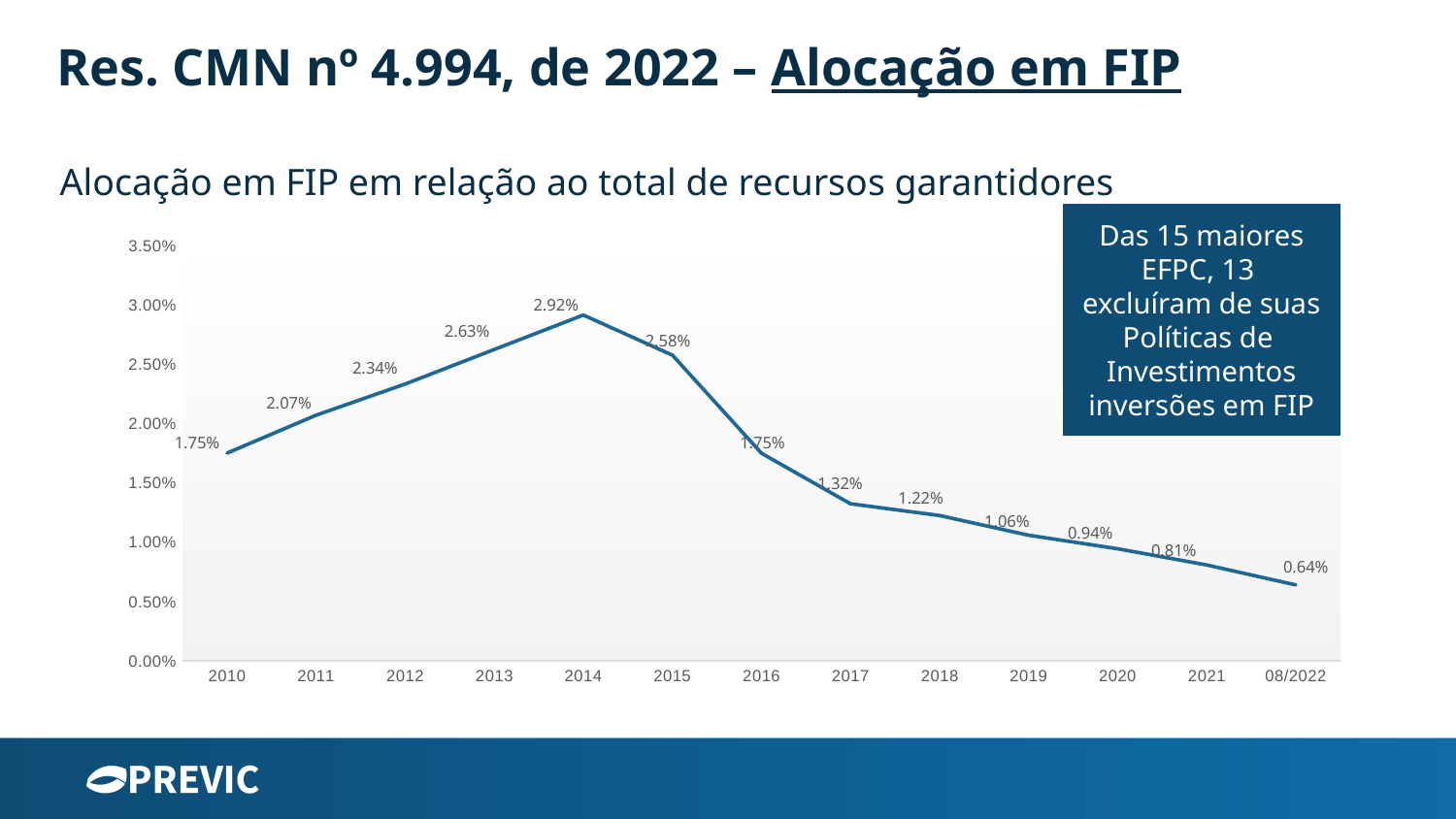
What is the value for 2014? 2.92% What is the value for 08/2022? 0.64% How many data points are plotted on the chart? 13 Which point on the x axis has the lowest value? 08/2022 What is the title of the chart? Alocação em FIP em relação ao total de recursos garantidores What is the value for 2018? 1.22% Is the value for 2013 greater or less than 2.50%? greater Which year has the highest value? 2014 What is the difference between the values for 2014 and 2015? 0.34% What type of chart is shown on the slide? Line chart Which is larger, the value for 2012 or the value for 2017? 2012 Do the values rise or fall from 2014 to 08/2022? fall